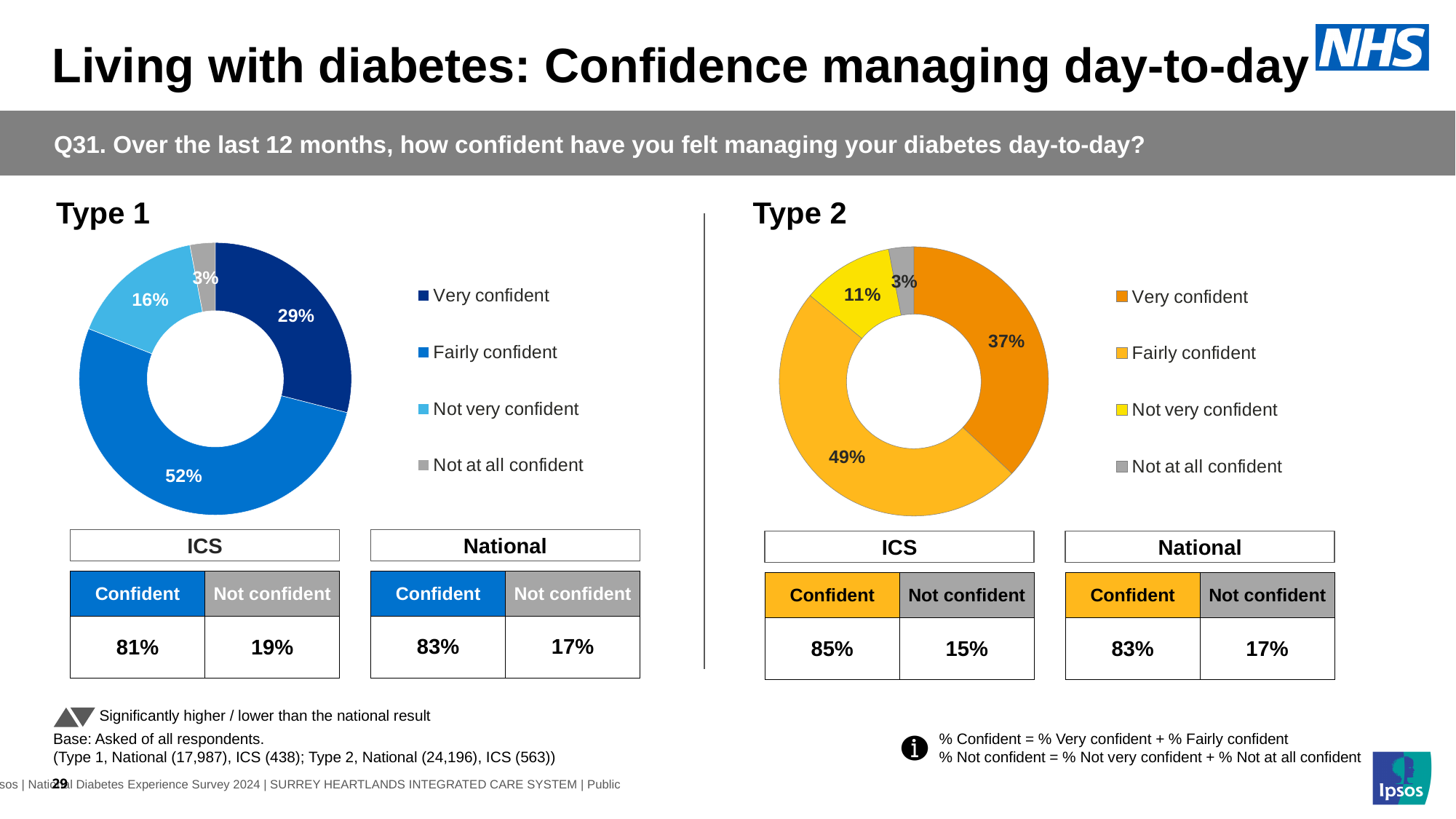
In the Type 2 chart, what percentage of respondents were Not at all confident? 3% In the Type 2 chart, which category has the smallest share? Not at all confident In the Type 1 chart, what percentage of respondents were Not very confident? 16% In the Type 1 chart, which is larger: Very confident or Not very confident? Very confident In the Type 2 chart, what colour represents Not very confident? Yellow In the Type 1 chart, what percentage of respondents were Fairly confident? 52% How many categories does the Type 1 chart show? 4 In the Type 1 chart, what is the combined share of Very confident and Fairly confident? 81% In the Type 1 chart, which category has the largest share? Fairly confident What kind of chart is used for Type 2? Doughnut (pie) chart In the Type 2 chart, what percentage of respondents were Very confident? 37% In the Type 2 chart, what is the difference between the Fairly confident and Very confident shares? 12%